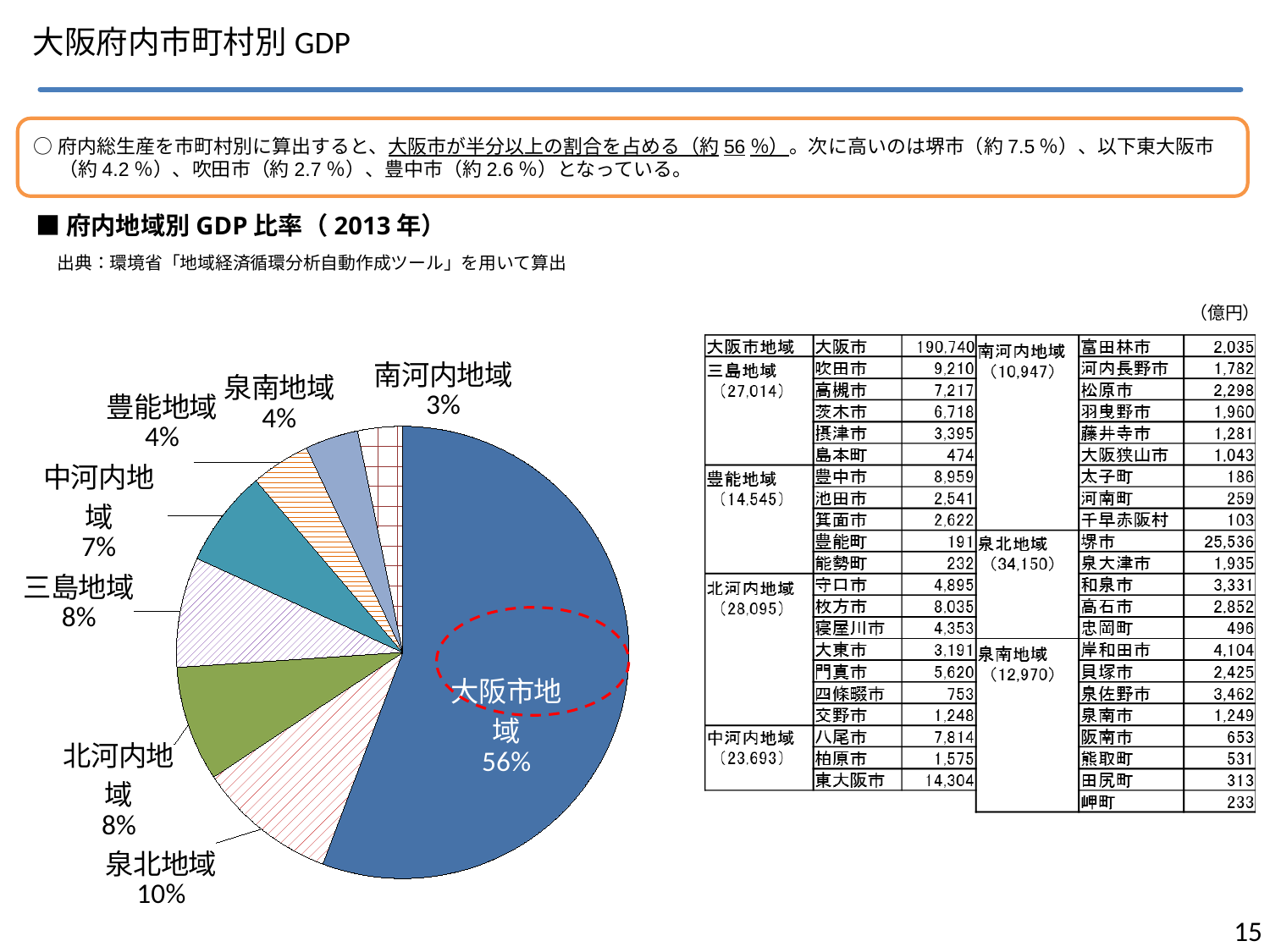
Which region has the largest slice of the pie? 大阪市地域 What is the title of the chart section on the slide? 府内地域別 GDP 比率（2013 年） What kind of chart is shown on the slide? Pie chart What share of the pie does 泉北地域 hold? 10% Which is larger, the share for 中河内地域 or the share for 豊能地域? 中河内地域 What is the value shown for 南河内地域 in the pie chart? 3% What is the difference in percentage points between 大阪市地域 and 泉北地域? 46 How many slices does the pie chart have? 8 What is the difference in percentage points between 泉北地域 and 北河内地域? 2 What is the value shown for 中河内地域 in the pie chart? 7% Which region has the smallest slice of the pie? 南河内地域 What share of the pie does 大阪市地域 hold? 56%